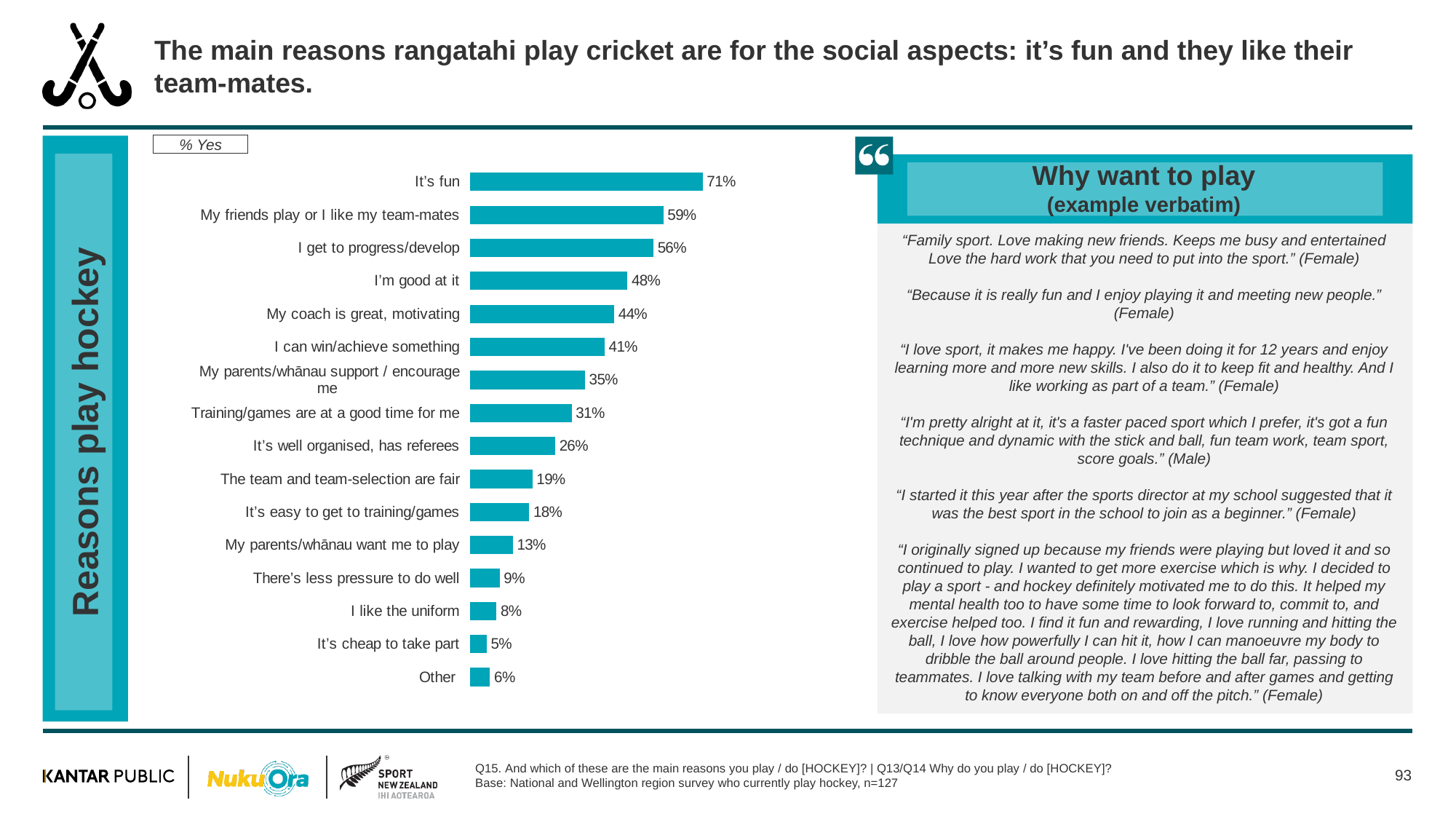
Which reason has the lowest percentage in the chart? It's cheap to take part What is the difference between "I get to progress/develop" and "I'm good at it"? 8% Which is larger: "Other" or "It's cheap to take part"? Other Which is larger: "Training/games are at a good time for me" or "It's well organised, has referees"? Training/games are at a good time for me What type of chart is used on this slide? Bar chart How many reasons (categories) are shown in the chart? 16 What percentage of respondents said "It's fun" is a reason they play hockey? 71% What percentage is shown for "I like the uniform"? 8% Which reason has the highest percentage in the chart? It's fun What is the value shown for "My coach is great, motivating"? 44% What label appears in the box above the chart indicating the measure shown? % Yes What is the difference between "It's fun" and "My friends play or I like my team-mates"? 12%